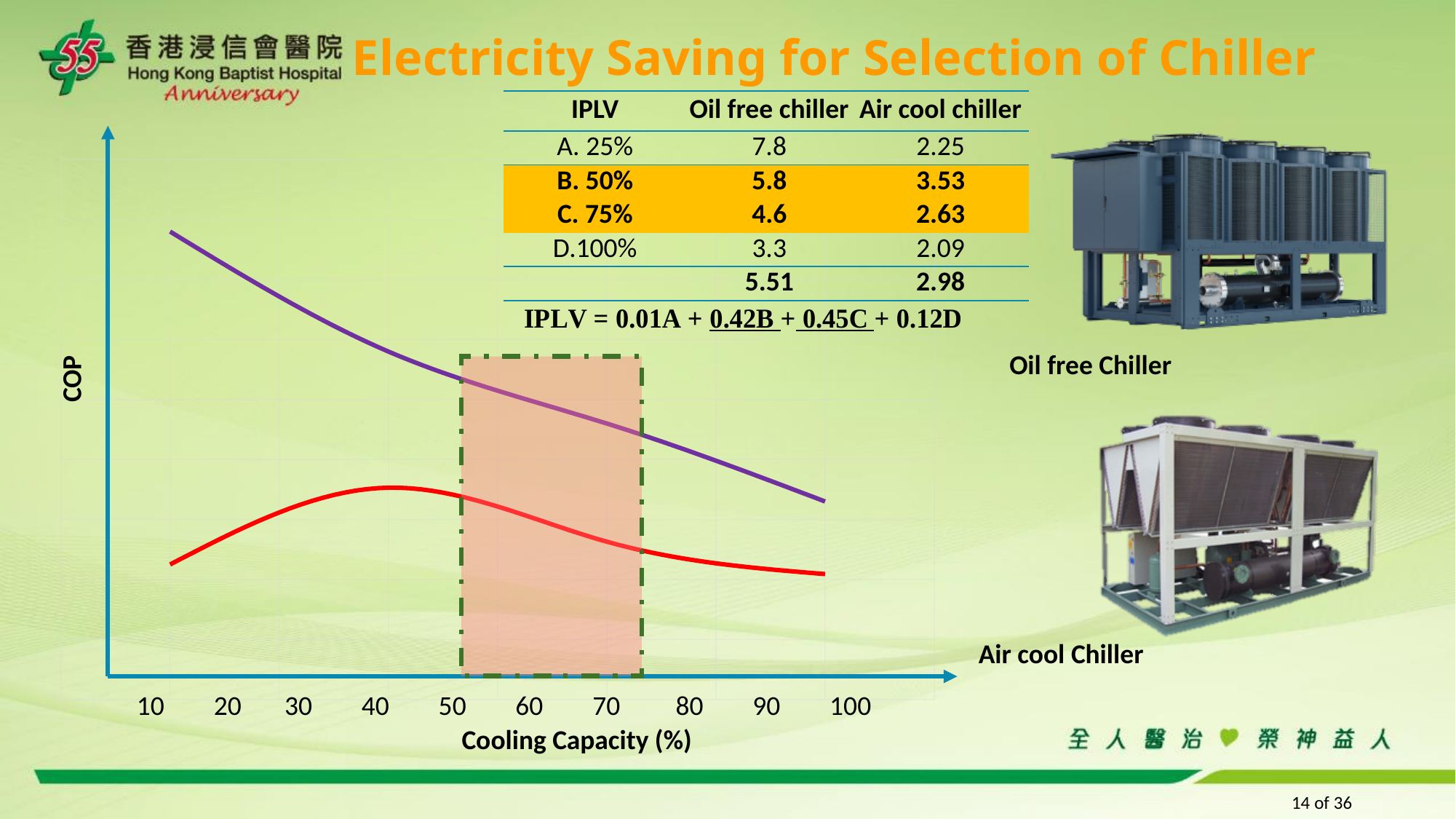
Which x-axis tick labels fall inside the shaded dashed box on the chart? 60 and 70 In the IPLV table above the chart, which load row has the highest Oil free chiller value? A. 25% In the IPLV table above the chart, what is the difference between the overall IPLV of the Oil free chiller (5.51) and the Air cool chiller (2.98)? 2.53 In the IPLV table above the chart, what is the Air cool chiller value at D.100%? 2.09 At 60% cooling capacity, which line shows the higher COP, the purple line or the red line? purple line Does the purple line rise or fall as cooling capacity increases from 10% to 100%? falls What is the label of the x axis of the chart? Cooling Capacity (%) What kind of chart is shown on the left of the slide? line chart How many tick labels are shown on the x axis of the chart? 10 In the IPLV table above the chart, what is the Oil free chiller value at B. 50%? 5.8 How many lines are plotted on the COP chart? 2 Does the red line rise then fall, or fall then rise, as cooling capacity increases? rises then falls